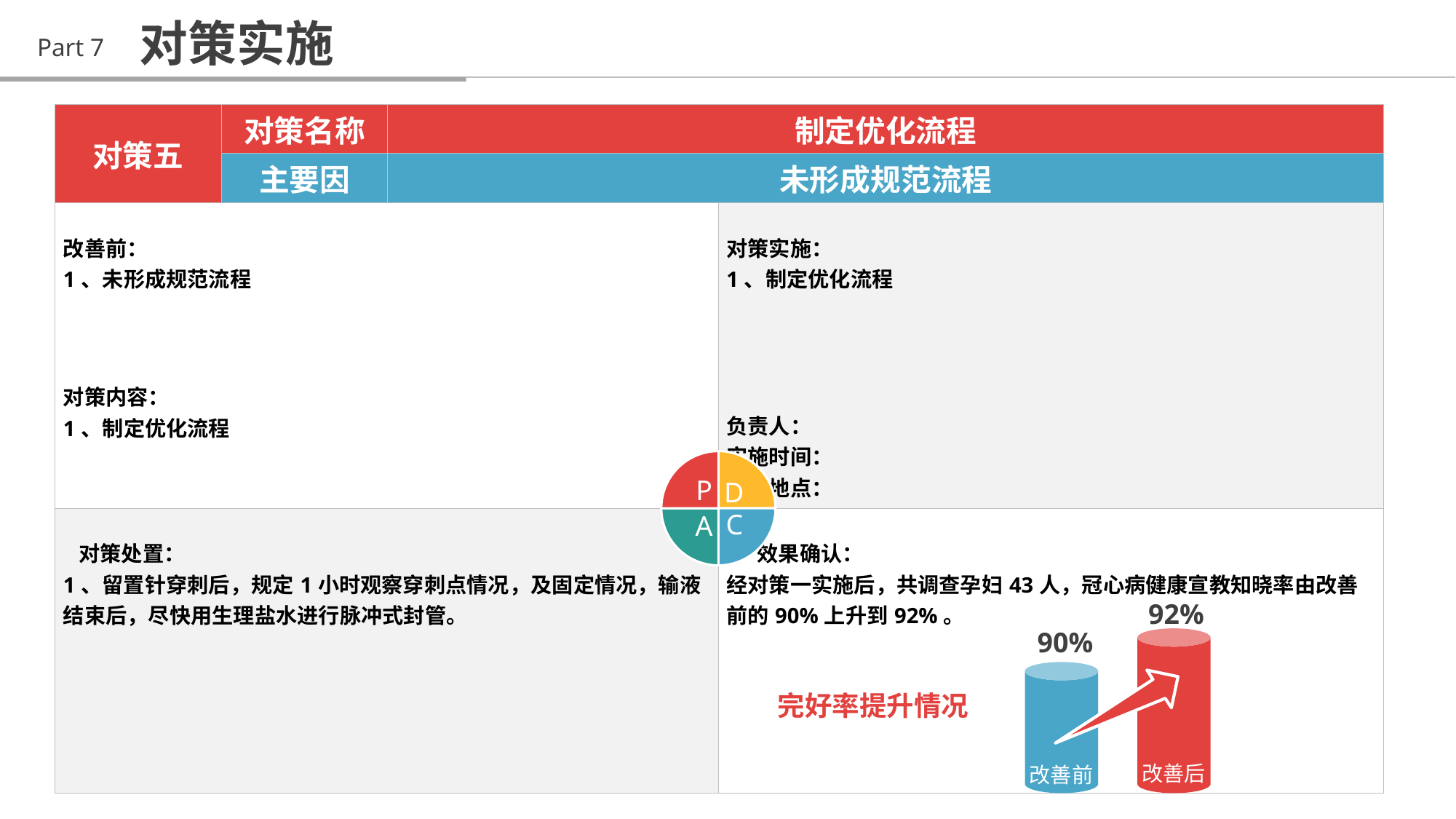
What is the difference between the values for 改善后 and 改善前? 2% How many categories are shown in the chart? 2 What is the value for 改善后 in the chart? 92% Which category has the lowest value in the chart? 改善前 What is the title of the chart? 完好率提升情况 What is the value for 改善前 in the chart? 90% Which category has the higher value, 改善前 or 改善后? 改善后 Do the values rise or fall from 改善前 to 改善后? rise What colour is the bar for 改善后? red Which category has the highest value in the chart? 改善后